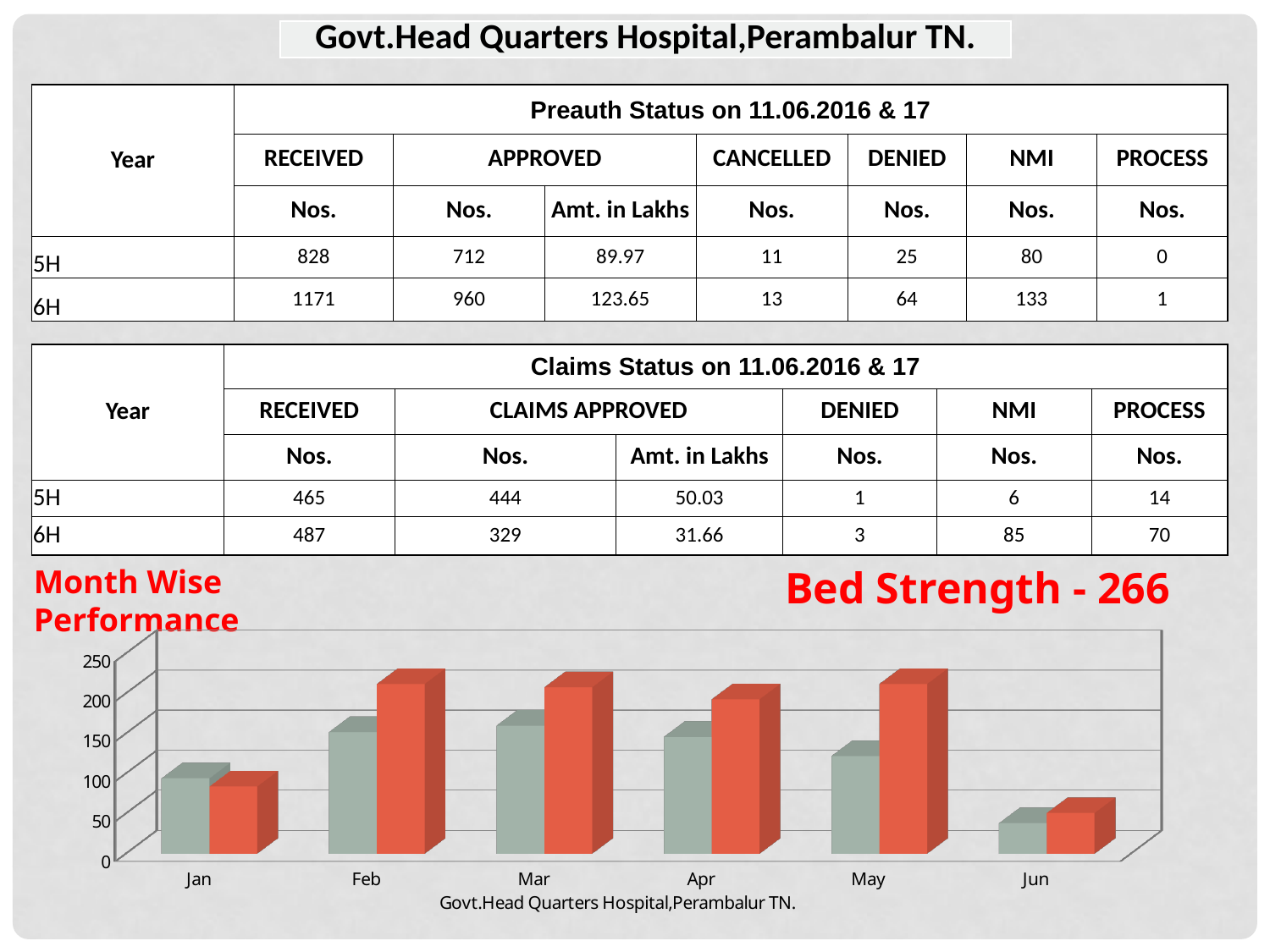
Which month has the lowest grey bar in the Month Wise Performance chart? Jun What kind of chart is shown under 'Month Wise Performance'? bar chart In the Month Wise Performance chart, is the red bar for May greater or less than 150? greater In the Month Wise Performance chart, which is larger: the grey bar for Mar or the grey bar for Jun? Mar How many months are shown on the x axis of the Month Wise Performance chart? 6 In the Month Wise Performance chart, which is larger: the red bar for Feb or the red bar for Jan? Feb In the Month Wise Performance chart, is the grey bar for Jan greater or less than 150? less In the Month Wise Performance chart, for Apr, which bar is taller: the grey bar or the red bar? red In the Month Wise Performance chart, is the red bar for Feb greater or less than 150? greater Which month has the lowest red bar in the Month Wise Performance chart? Jun What text appears below the x axis of the Month Wise Performance chart? Govt.Head Quarters Hospital,Perambalur TN.